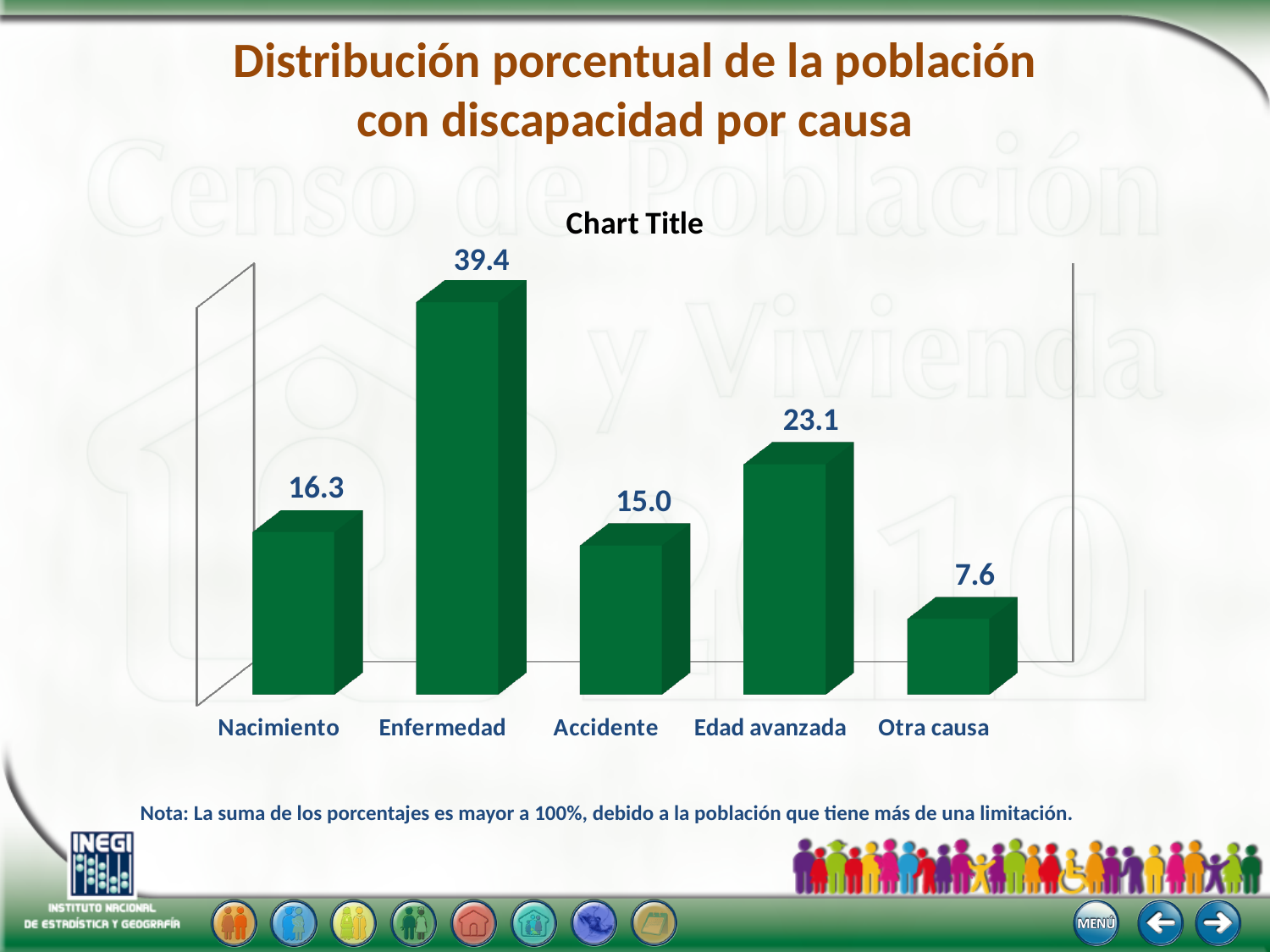
What is the value for Enfermedad? 39.4 What kind of chart is shown on the slide? Bar chart Which category has the lowest value? Otra causa What is the value for Otra causa? 7.6 What is the difference between the values for Enfermedad and Edad avanzada? 16.3 How many categories are shown on the x axis? 5 Which category has the highest value? Enfermedad What is the value for Edad avanzada? 23.1 Which is larger, the value for Nacimiento or the value for Accidente? Nacimiento What is the difference between the values for Nacimiento and Accidente? 1.3 What is the title shown above the chart area? Chart Title What is the value for Nacimiento? 16.3